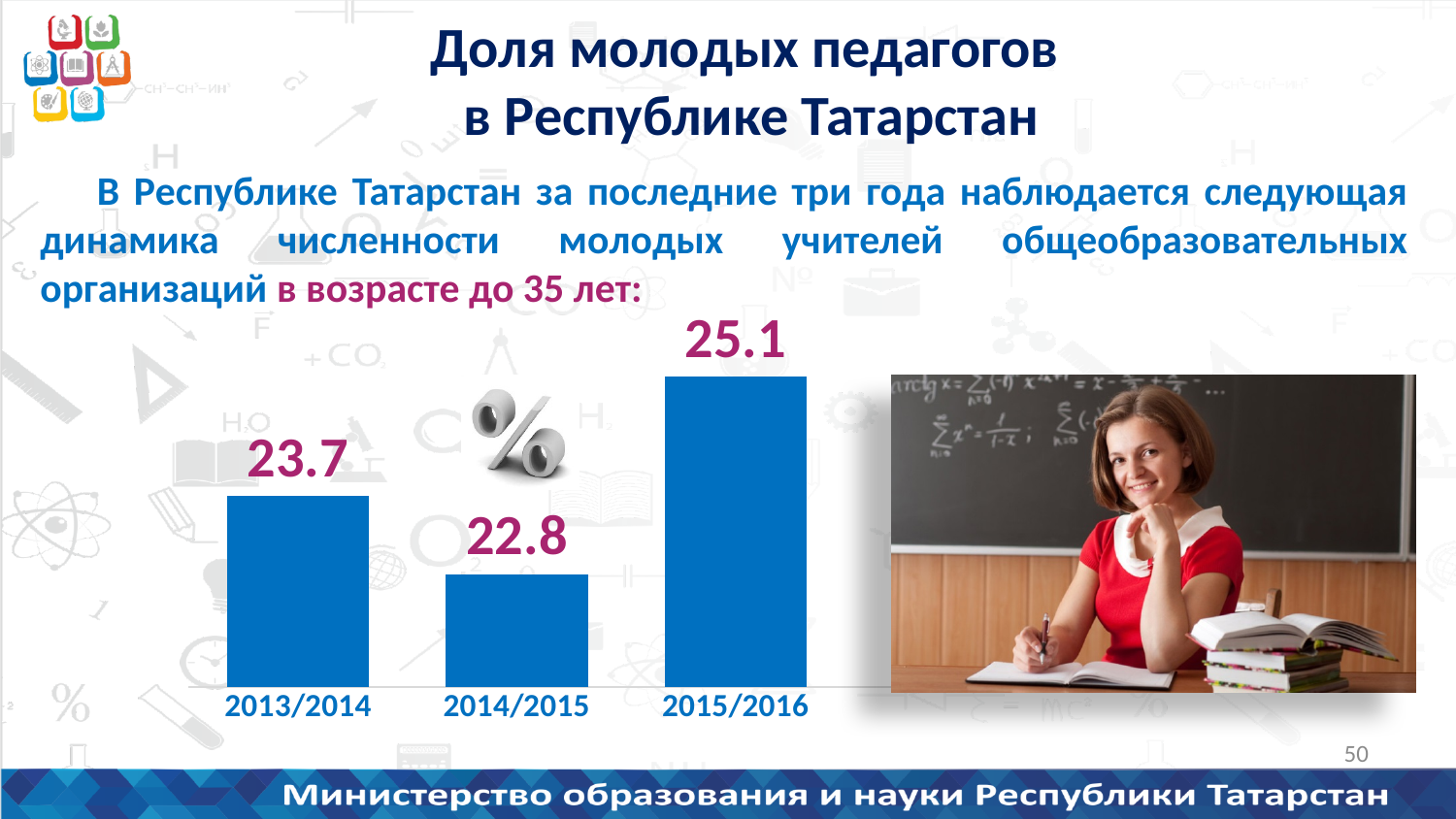
Which is larger, the value for 2013/2014 or the value for 2015/2016? 2015/2016 What is the value for 2014/2015? 22.8 What kind of chart is shown on the slide? bar chart How many categories (years) are shown in the chart? 3 What is the difference between the values for 2015/2016 and 2014/2015? 2.3 Does the value rise or fall from 2014/2015 to 2015/2016? rise Which year has the highest value? 2015/2016 What colour are the bars in the chart? blue What is the difference between the values for 2013/2014 and 2014/2015? 0.9 Which year has the lowest value? 2014/2015 What is the value for 2015/2016? 25.1 What is the value for 2013/2014? 23.7